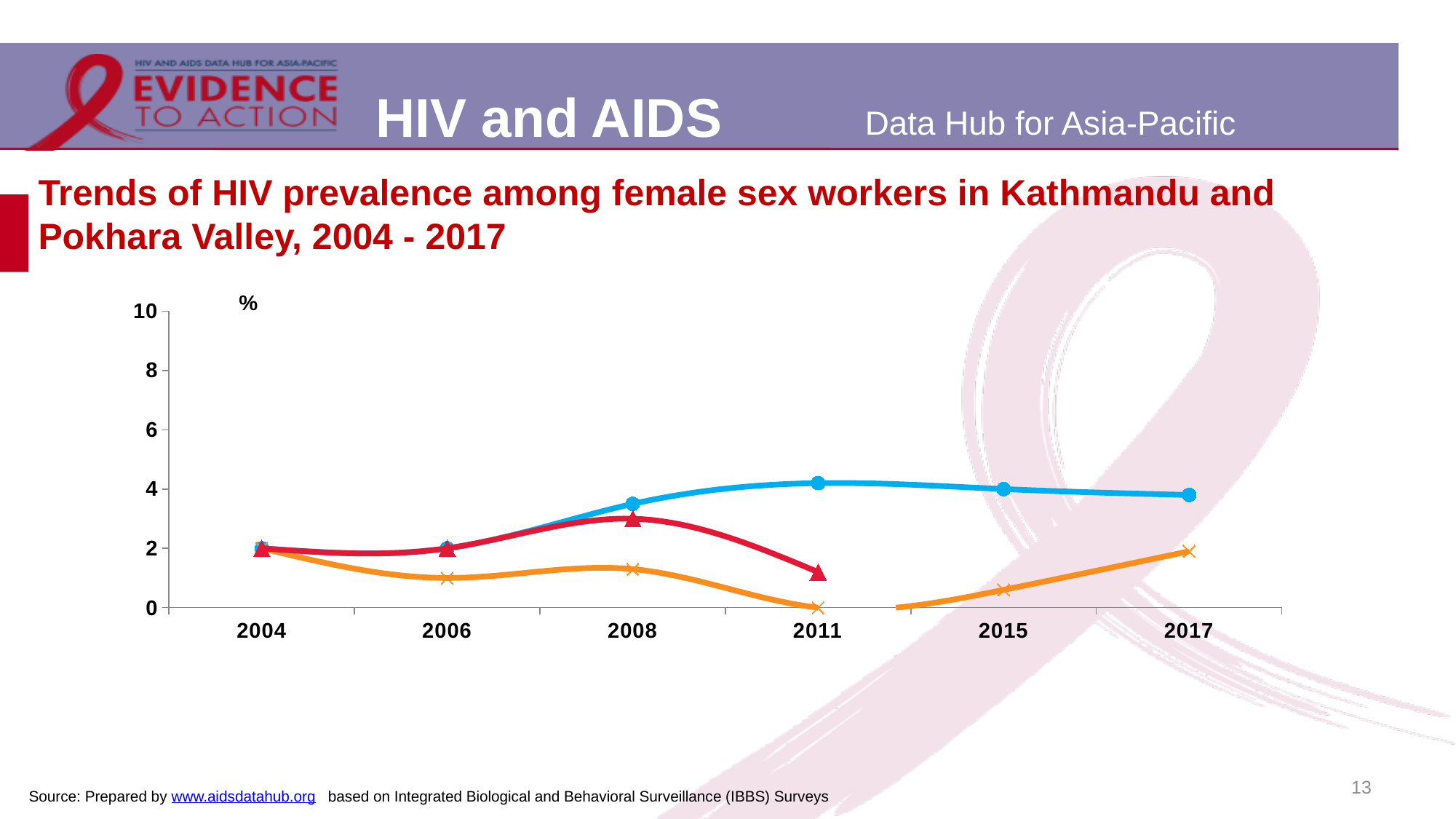
Is the value of the blue circle-marker line in 2008 greater or less than 2? greater Is the value of the red triangle-marker line in 2011 greater or less than 2? less Is the value of the orange x-marker line in 2006 greater or less than 2? less What kind of chart is shown on the slide? line chart How many years are labelled on the x axis of the chart? 6 What is the first year shown on the x axis? 2004 What unit is shown at the top of the y axis? % Does the orange x-marker line rise or fall between 2011 and 2017? rise In 2011, which line has the higher value: the blue circle-marker line or the red triangle-marker line? the blue circle-marker line Does the blue circle-marker line rise or fall between 2004 and 2011? rise